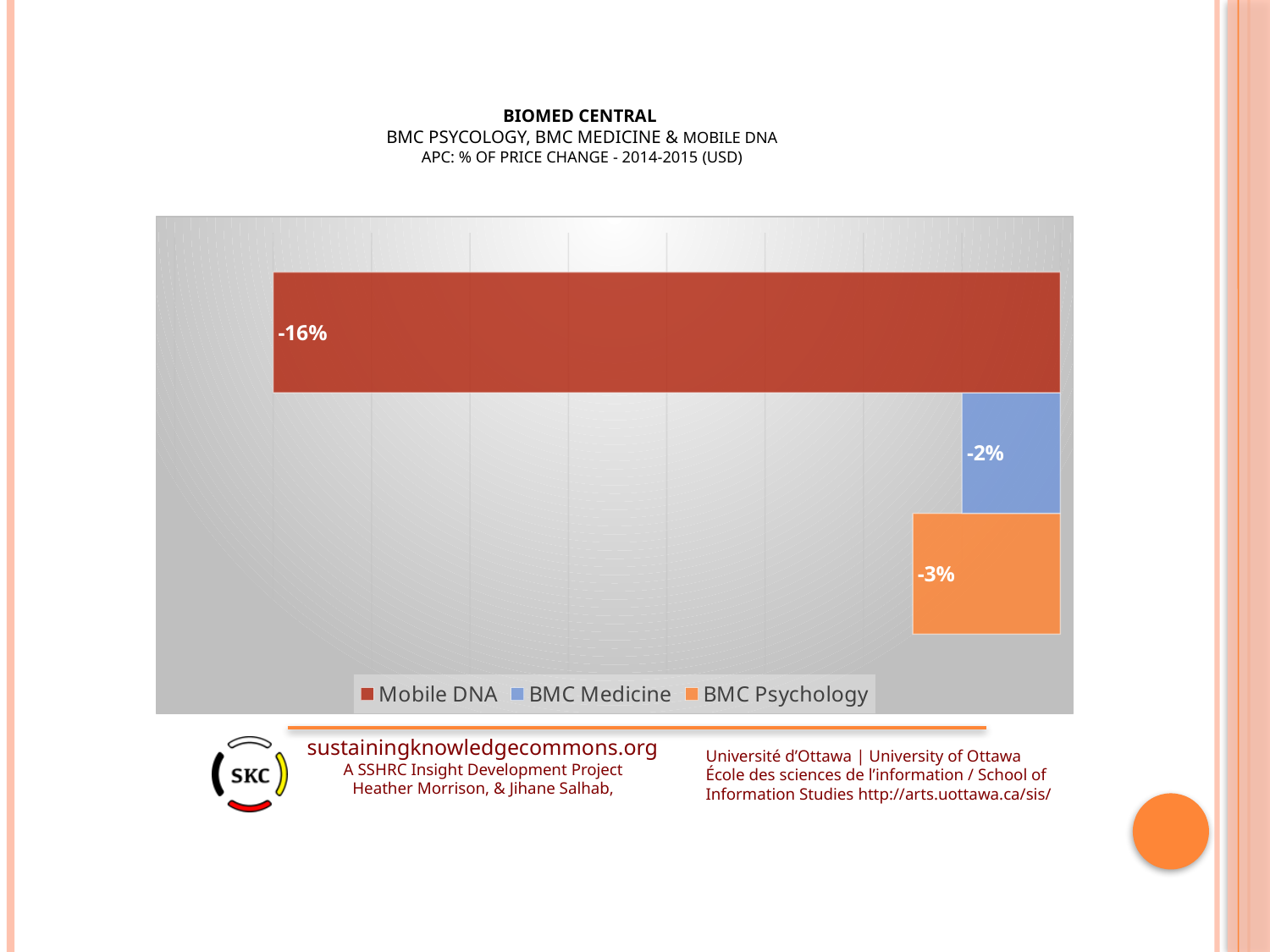
What is the APC price change shown for BMC Psychology? -3% Which journal has the larger price decrease, BMC Medicine or BMC Psychology? BMC Psychology By how many percentage points does the price change for Mobile DNA differ from that of BMC Psychology? 13 percentage points Which journal shows the smallest price change? BMC Medicine How many bars are plotted in the chart? 3 How many series does the legend list? 3 What kind of chart is shown on the slide? Bar chart By how many percentage points does the price change for BMC Psychology differ from that of BMC Medicine? 1 percentage point What is the APC price change shown for BMC Medicine? -2% Which journal shows the largest price decrease? Mobile DNA Which colour represents BMC Medicine in the legend? Blue What is the APC price change shown for Mobile DNA? -16%